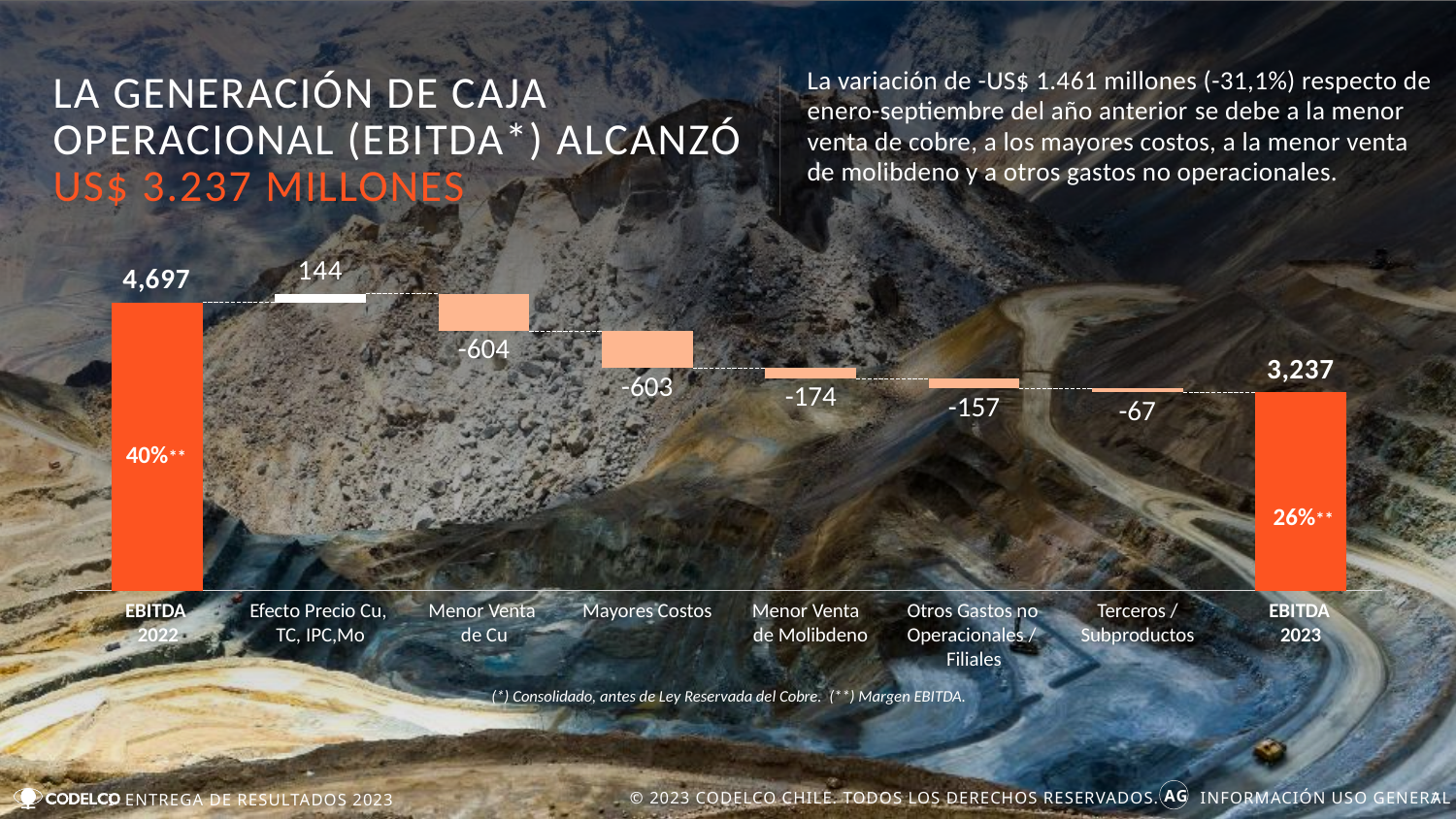
What EBITDA margin is shown on the EBITDA 2023 bar? 26% Which category is the only one with a positive contribution between EBITDA 2022 and EBITDA 2023? Efecto Precio Cu, TC, IPC,Mo What is the value shown for Menor Venta de Molibdeno? -174 What is the value shown for EBITDA 2023? 3,237 What is the value shown for Mayores Costos? -603 What is the difference between EBITDA 2022 and EBITDA 2023? 1,461 What is the value shown for EBITDA 2022? 4,697 What is the value shown for Terceros / Subproductos? -67 What kind of chart is shown on the slide? Waterfall bar chart How many categories are shown along the x axis of the chart? 8 Which is larger in absolute value, Menor Venta de Molibdeno or Otros Gastos no Operacionales / Filiales? Menor Venta de Molibdeno What is the value shown for Menor Venta de Cu? -604